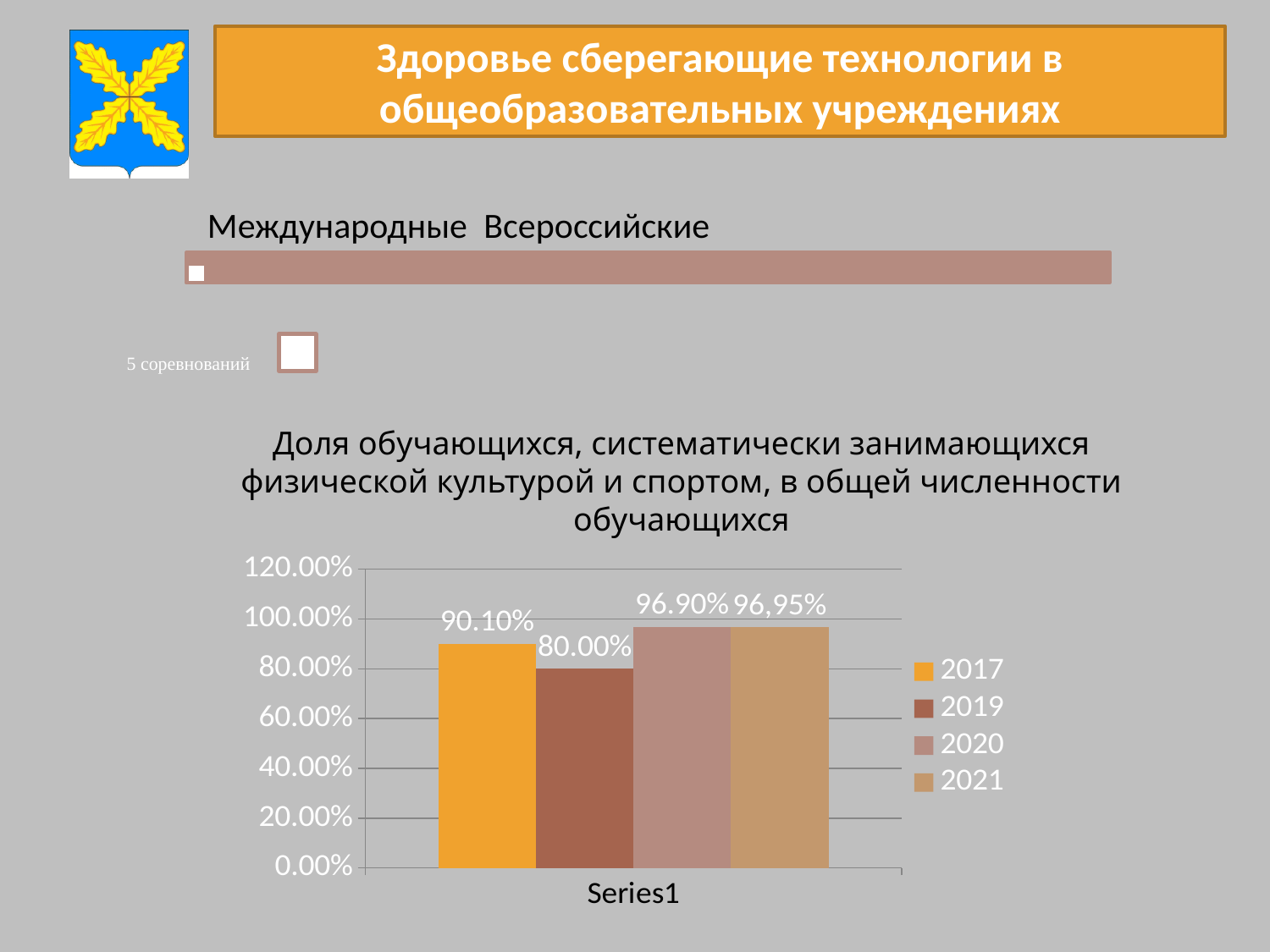
What is the category label shown on the x axis of the chart? Series1 Which year has the lowest value in the chart? 2019 What kind of chart is shown on the slide? bar chart What is the value for 2019 in the chart? 80.00% Which is larger, the value for 2017 or the value for 2020? 2020 What is the value for 2021 in the chart? 96,95% How many series does the legend list? 4 What is the value for 2017 in the chart? 90.10% What is the difference between the values for 2020 and 2019? 16.90% Is the value for 2019 greater or less than 100.00%? less What is the difference between the values for 2017 and 2019? 10.10% What is the value for 2020 in the chart? 96.90%